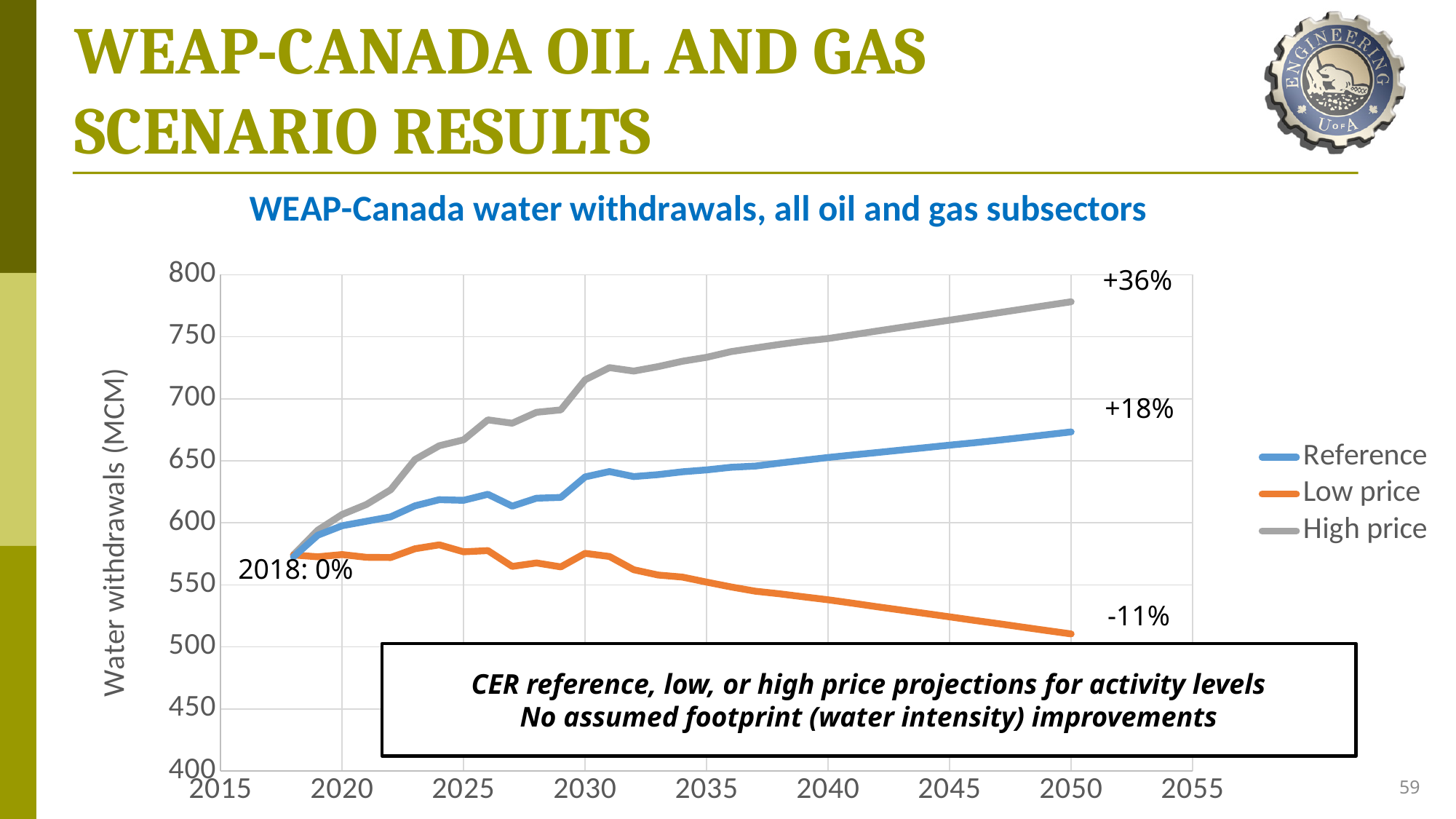
What is the label on the y axis? Water withdrawals (MCM) What is the title of the chart? WEAP-Canada water withdrawals, all oil and gas subsectors What percentage change is labelled at the end of the High price line? +36% Which series has the highest water withdrawals in 2050? High price What kind of chart is shown on the slide? line chart What percentage change is labelled at the end of the Low price line? -11% What percentage change is labelled at the end of the Reference line? +18% Does the Low price series rise or fall between 2030 and 2050? fall Which series has the lowest water withdrawals in 2050? Low price Is the Low price value in 2050 greater or less than 550? less How many series does the legend list? 3 Is the High price value in 2050 greater or less than 750? greater